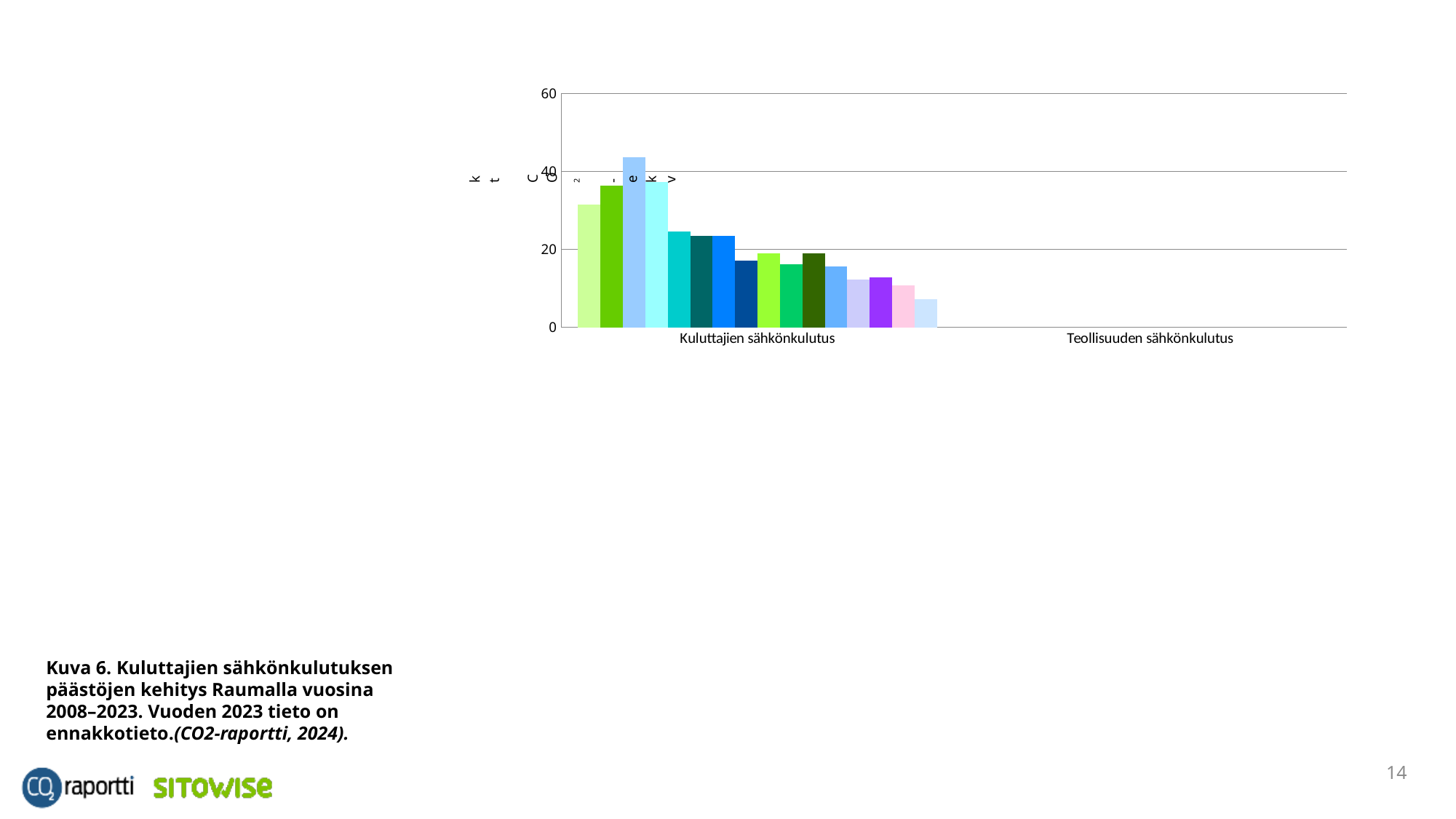
Do the bars in the Kuluttajien sähkönkulutus group generally rise or fall from left to right? fall What is the highest value shown on the y axis of the chart? 60 Is the tallest bar in the Kuluttajien sähkönkulutus group greater or less than 40? greater Is the first (leftmost) bar in the Kuluttajien sähkönkulutus group greater or less than 20? greater Which x-axis category has bars plotted in the chart? Kuluttajien sähkönkulutus Is the last (rightmost) bar in the Kuluttajien sähkönkulutus group greater or less than 20? less How many categories are labelled on the x axis of the chart? 2 Which is larger, the leftmost bar or the rightmost bar in the Kuluttajien sähkönkulutus group? the leftmost bar What kind of chart is shown on the slide? bar chart How many bars are plotted in the Kuluttajien sähkönkulutus group? 16